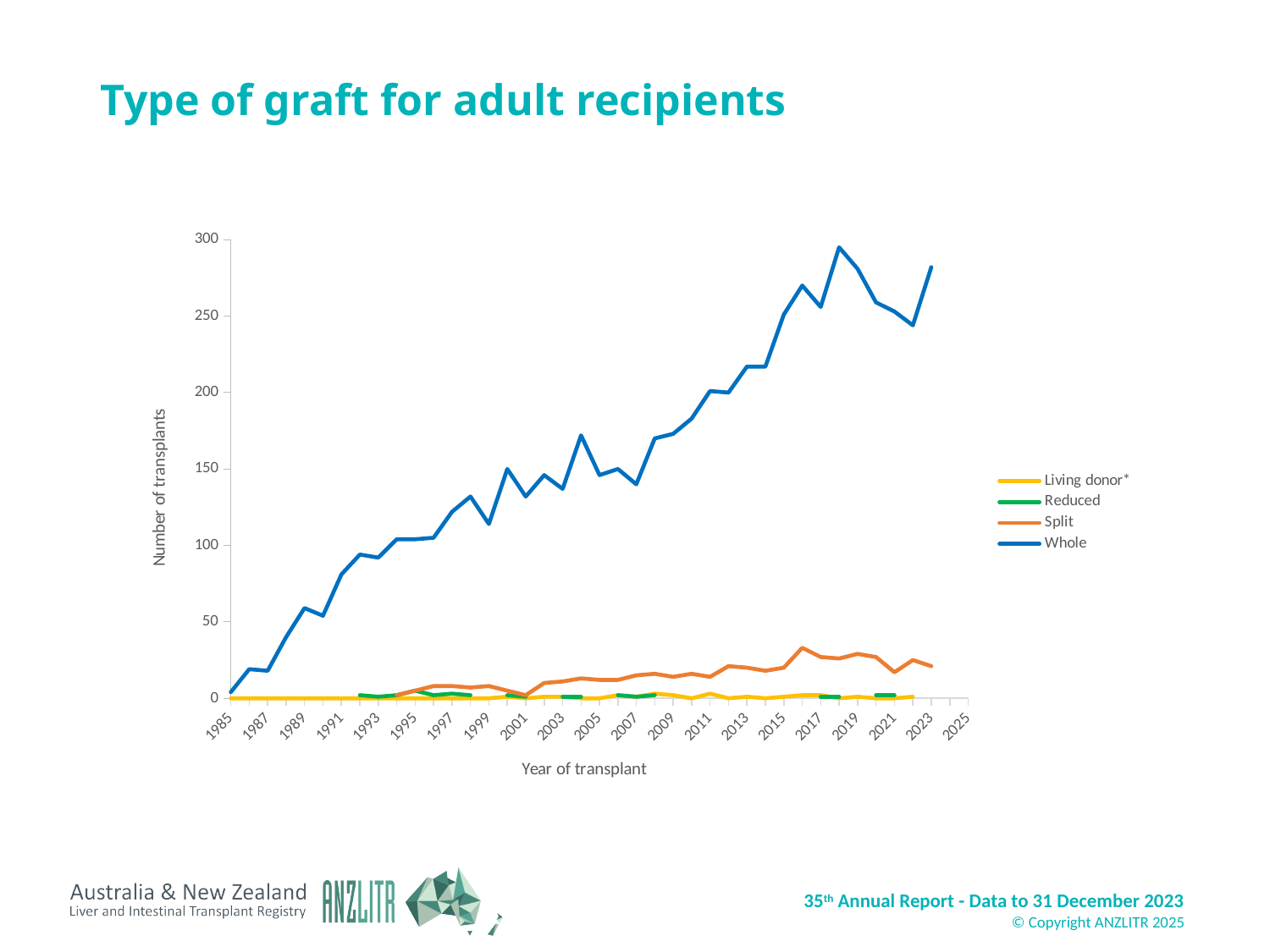
What is the label of the vertical axis? Number of transplants Is the value for Whole grafts in 1985 greater or less than 50? less Which is larger in 2016, the number of Whole grafts or the number of Split grafts? Whole In which year does the Whole series reach its highest point? 2018 Which series has the highest number of transplants across the years shown? Whole What is the title of the chart? Type of graft for adult recipients What kind of chart is shown on the slide? Line chart Is the value for Whole grafts in 2018 greater or less than 250? greater Is the value for Whole grafts in 2010 greater or less than 150? greater How many series does the legend list? 4 Does the number of Whole graft transplants generally rise or fall from 1985 to 2023? rise